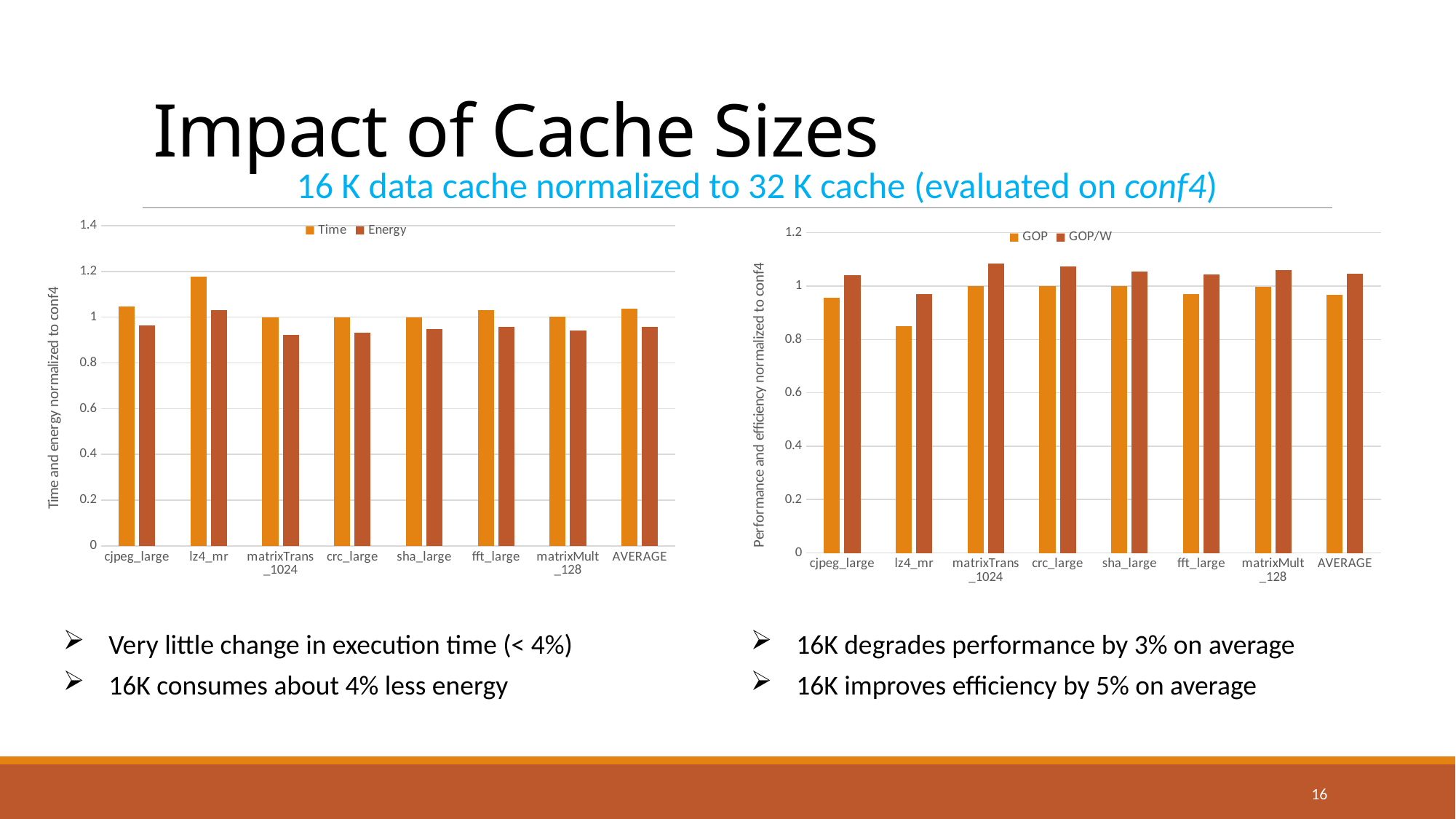
What is the y-axis label of the right chart? Performance and efficiency normalized to conf4 In the left chart, for lz4_mr, which is larger: Time or Energy? Time In the left chart, is the Time value for lz4_mr greater or less than 1? greater In the right chart, which category has the lowest GOP value? lz4_mr In the left chart, which category has the highest Time value? lz4_mr In the right chart, is the GOP value for lz4_mr greater or less than 1? less In the left chart, is the Energy value for matrixTrans_1024 greater or less than 1? less How many series does the legend of the right chart list? 2 In the right chart, for matrixTrans_1024, which is larger: GOP or GOP/W? GOP/W What kind of chart is the left chart on the slide? bar chart How many categories are shown on the x axis of the right chart? 8 What are the two series named in the legend of the left chart? Time and Energy